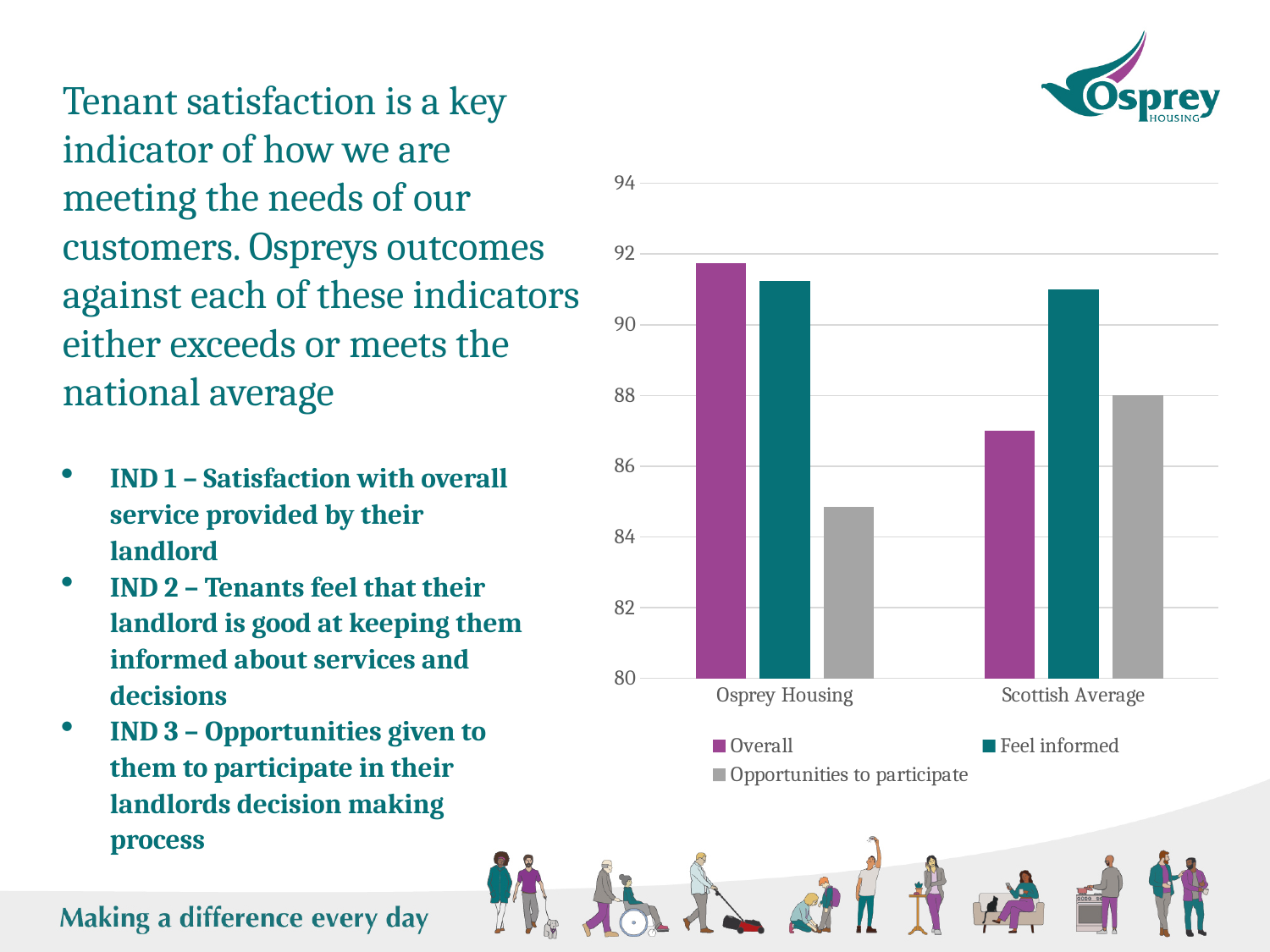
Which is larger: the Opportunities to participate value for Osprey Housing or for Scottish Average? Scottish Average Is the Overall value for Osprey Housing greater or less than 90? greater Is the Opportunities to participate value for Osprey Housing greater or less than 86? less Which series has the lowest value for Osprey Housing? Opportunities to participate How many series does the chart's legend list? 3 Which series has the highest value for Scottish Average? Feel informed Is the Overall value for Scottish Average greater or less than 88? less What colour are the bars for the Feel informed series? Teal What kind of chart is shown on the slide? Bar chart Which series has the lowest value for Scottish Average? Overall How many categories are shown on the x axis of the chart? 2 Which is larger: the Overall value for Osprey Housing or the Overall value for Scottish Average? Osprey Housing